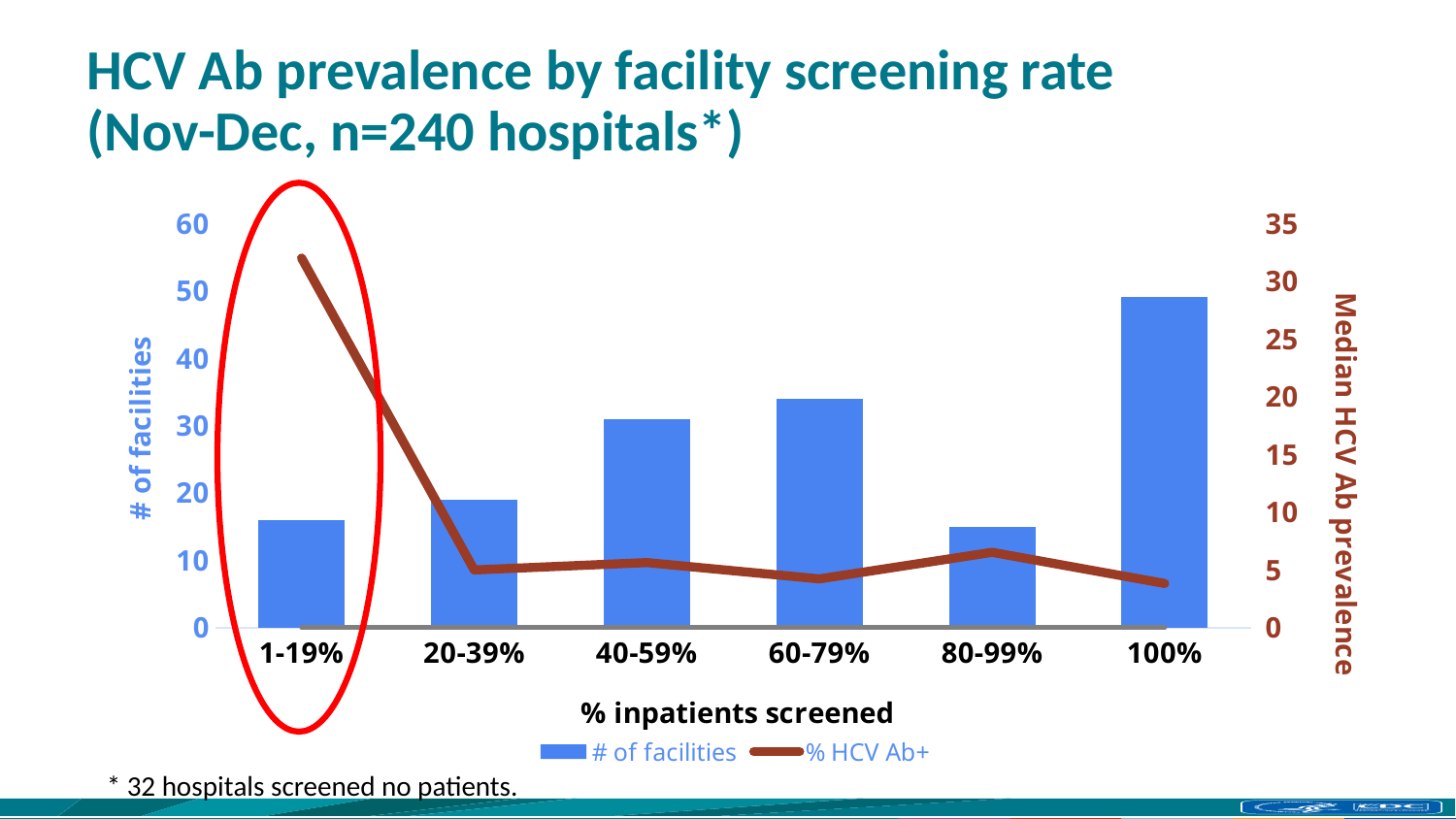
How many series does the legend list? 2 Which has more facilities, the 40-59% category or the 20-39% category? 40-59% Is the median HCV Ab prevalence for the 100% category greater or less than 10? less Which screening-rate category has the highest number of facilities? 100% Is the number of facilities for the 1-19% category greater or less than 20? less What type of chart is shown on the slide? A combined bar and line chart What is the title of the x axis? % inpatients screened Is the median HCV Ab prevalence for the 1-19% category greater or less than 25? greater Does the % HCV Ab+ line rise or fall between the 1-19% and 20-39% categories? fall How many screening-rate categories are shown on the x axis? 6 Which screening-rate category has the highest median HCV Ab prevalence? 1-19%